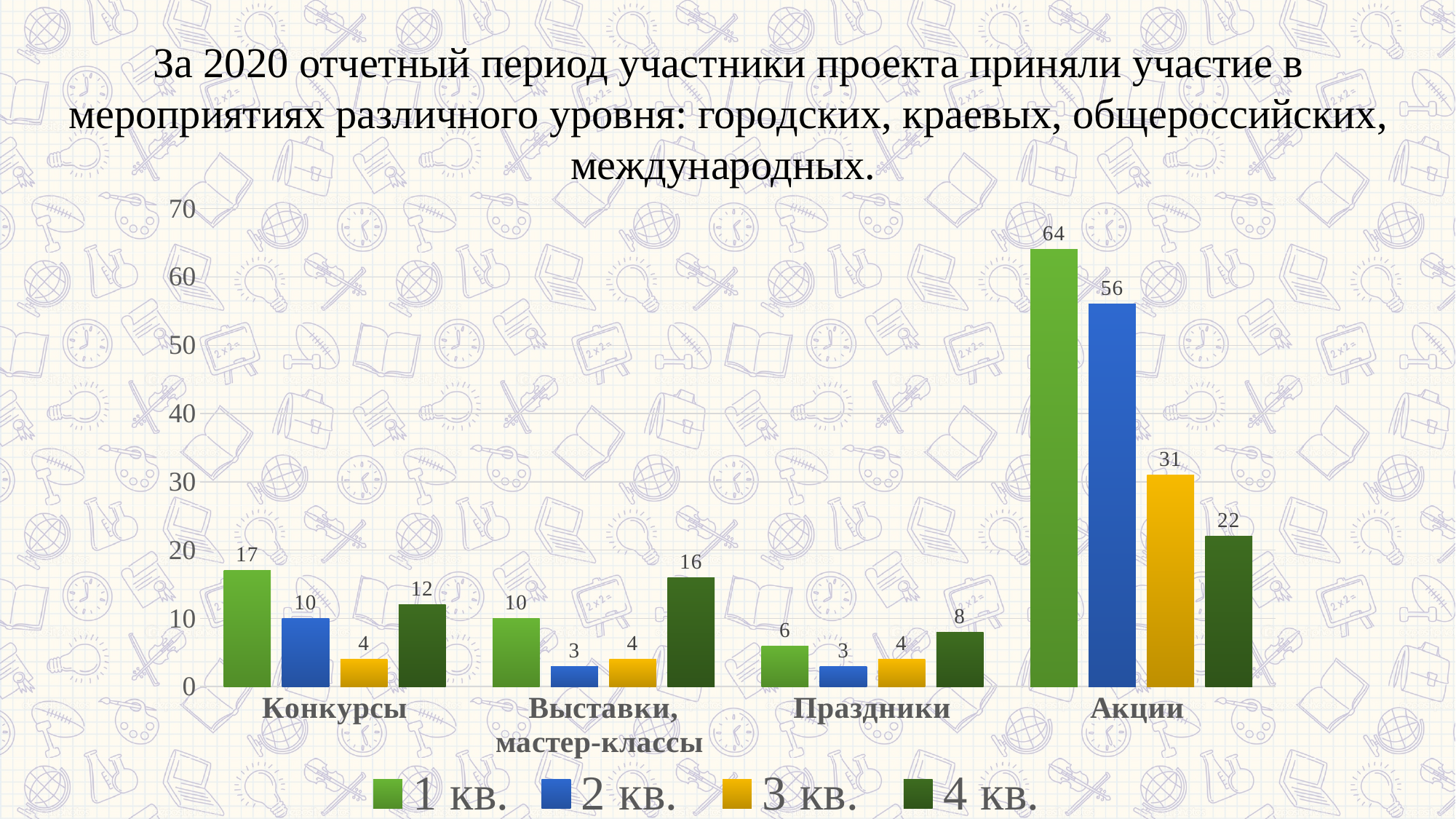
How many series does the legend list? 4 Which is larger in the Конкурсы category: the value for 1 кв. or the value for 4 кв.? 1 кв. What is the value for 2 кв. in the Праздники category? 3 Which category has the lowest value for 1 кв.? Праздники What is the difference between the 1 кв. and 2 кв. values in the Акции category? 8 How many categories are shown on the x axis? 4 What is the value for 1 кв. in the Акции category? 64 What is the value for 4 кв. in the Выставки, мастер-классы category? 16 What is the value for 3 кв. in the Конкурсы category? 4 Which series is shown in blue in the legend? 2 кв. What kind of chart is shown on the slide? Bar chart Which category has the highest value for 2 кв.? Акции